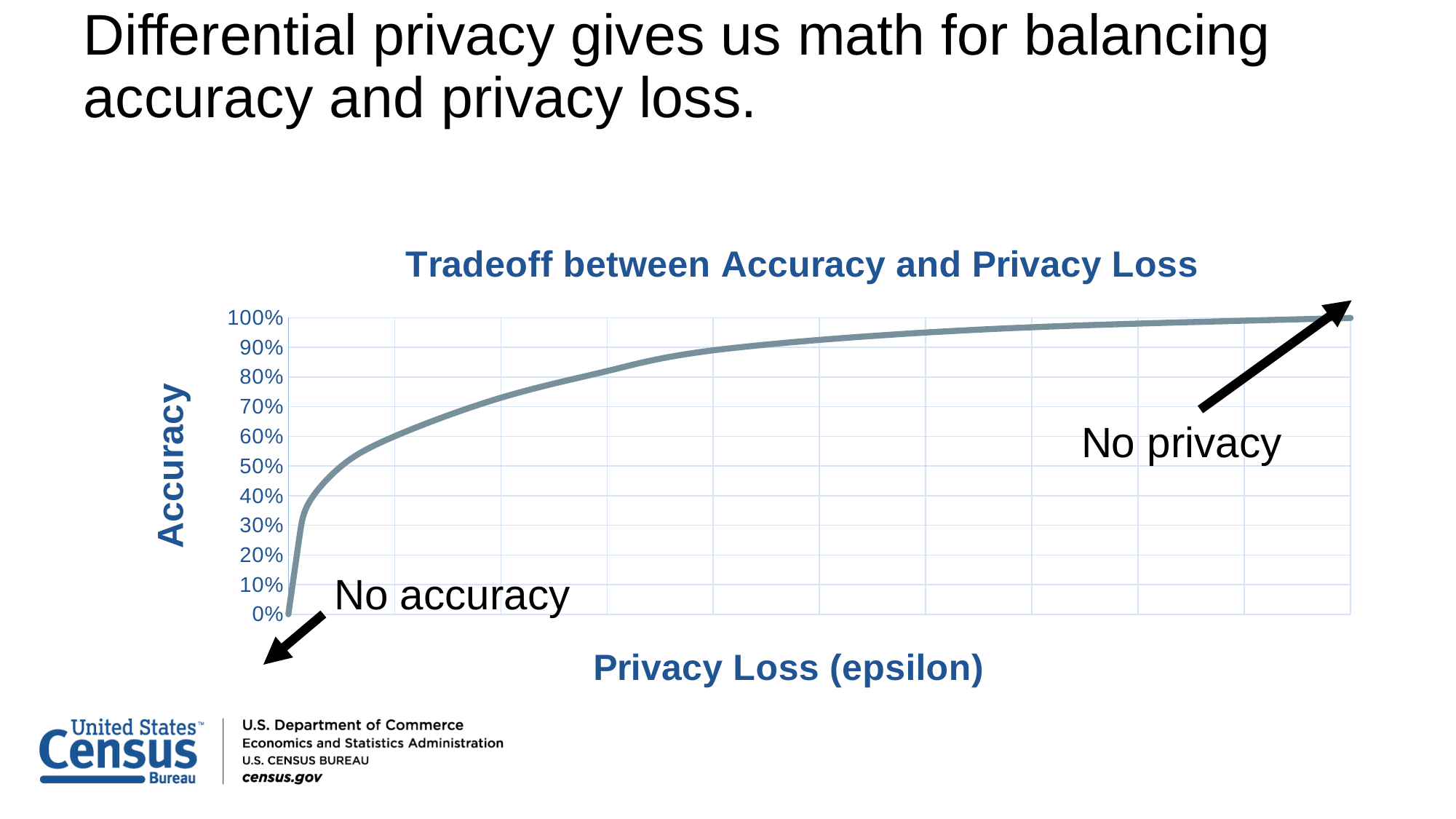
Does accuracy rise or fall as privacy loss increases along the x axis? rise What kind of chart is shown on the slide? line chart How many lines are plotted on the chart? 1 What is the label of the x axis of the chart? Privacy Loss (epsilon) What is the title of the chart? Tradeoff between Accuracy and Privacy Loss At the left end of the curve, is accuracy greater or less than 10%? less What is the highest value shown on the y axis of the chart? 100% What is the lowest value shown on the y axis of the chart? 0% At the right end of the curve, is accuracy greater or less than 90%? greater